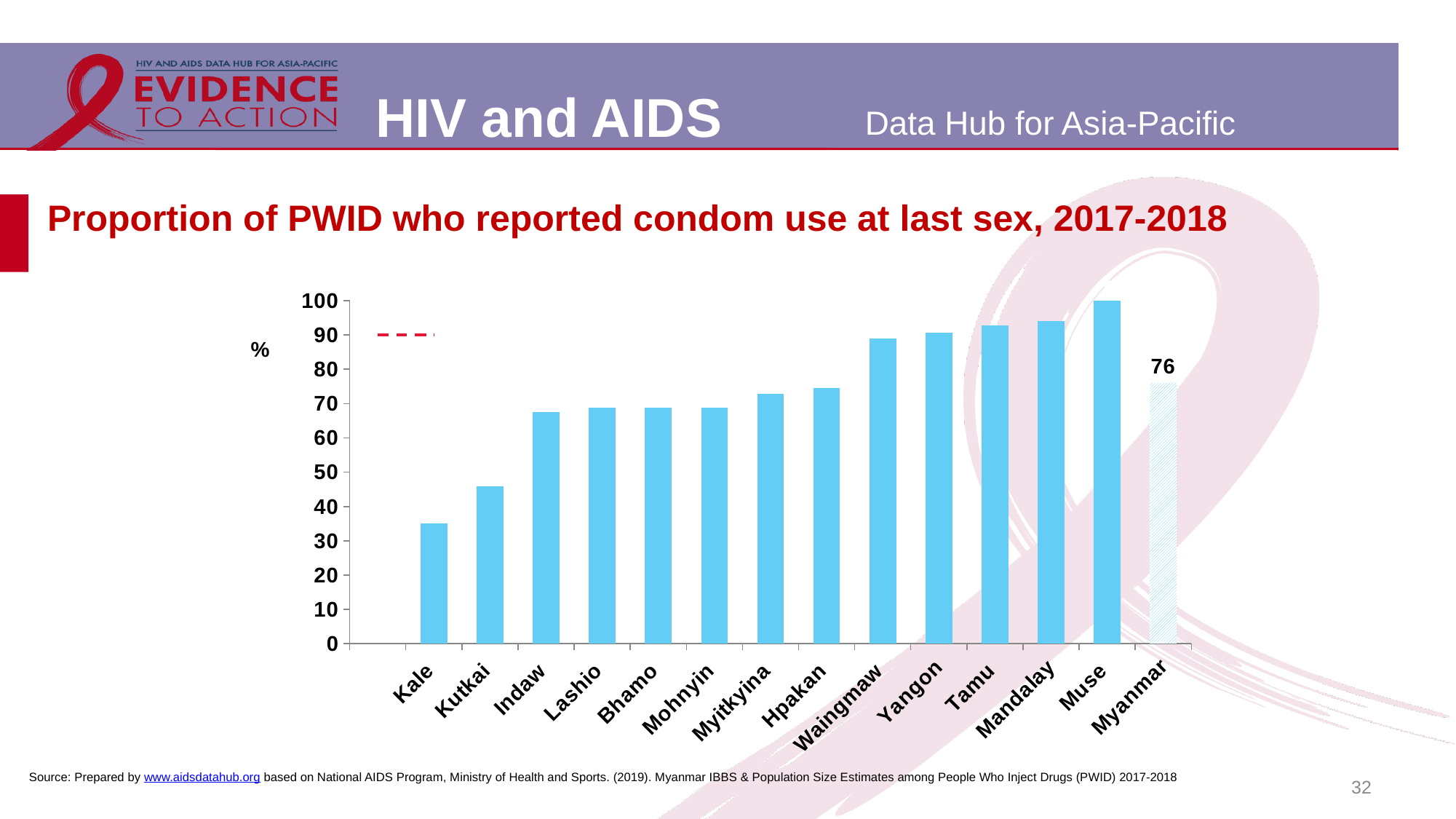
Which is larger, the value for Tamu or the value for Hpakan? Tamu Is the value for Kutkai greater or less than 50? less Which category has the lowest bar? Kale What unit label is shown on the y axis? % What is the title of the chart? Proportion of PWID who reported condom use at last sex, 2017-2018 Is the value for Waingmaw greater or less than 80? greater Is the value for Kale greater or less than 40? less What is the value shown for Myanmar? 76 How many categories are shown on the x axis? 14 Do the values generally rise or fall from Kale to Muse along the x axis? Rise Which category has the highest bar? Muse What kind of chart is shown on the slide? Bar chart